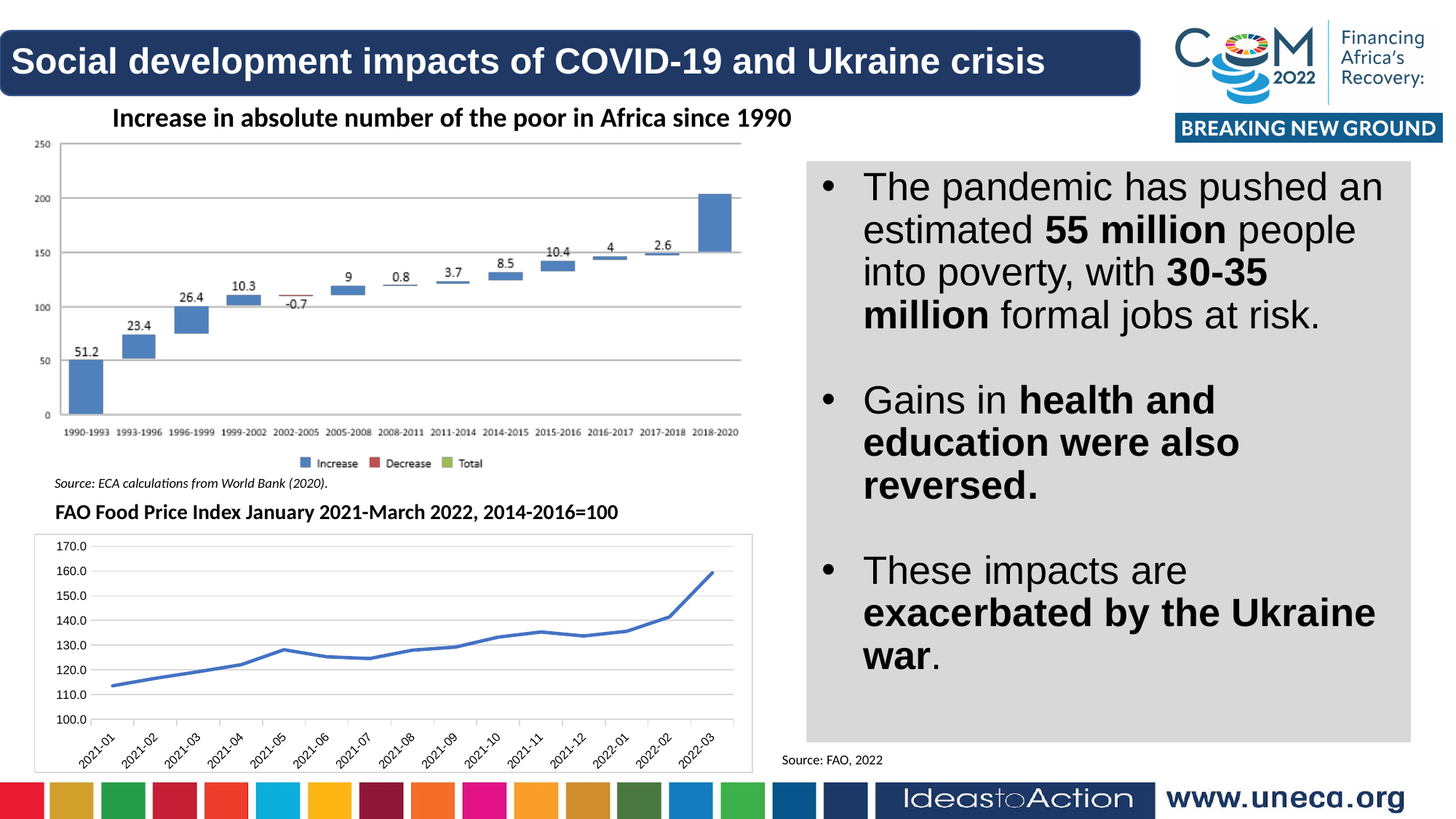
What kind of chart is 'FAO Food Price Index January 2021-March 2022, 2014-2016=100'? line chart In the chart 'Increase in absolute number of the poor in Africa since 1990', how many periods are shown on the x axis? 13 In the chart 'FAO Food Price Index January 2021-March 2022, 2014-2016=100', how many months are plotted? 15 In the chart 'Increase in absolute number of the poor in Africa since 1990', what is the value for 2002-2005? -0.7 In the chart 'Increase in absolute number of the poor in Africa since 1990', which labelled period shows a decrease? 2002-2005 In the chart 'Increase in absolute number of the poor in Africa since 1990', what is the value for 1996-1999? 26.4 In the chart 'Increase in absolute number of the poor in Africa since 1990', which is larger, the value for 2015-2016 or the value for 2016-2017? 2015-2016 In the chart 'Increase in absolute number of the poor in Africa since 1990', how many entries does the legend list? 3 In the chart 'FAO Food Price Index January 2021-March 2022, 2014-2016=100', is the value for 2022-03 greater or less than 150.0? greater In the chart 'Increase in absolute number of the poor in Africa since 1990', what is the difference between the values for 1993-1996 and 1996-1999? 3 In the chart 'Increase in absolute number of the poor in Africa since 1990', what is the value for 1990-1993? 51.2 In the chart 'FAO Food Price Index January 2021-March 2022, 2014-2016=100', is the value for 2021-01 greater or less than 120.0? less